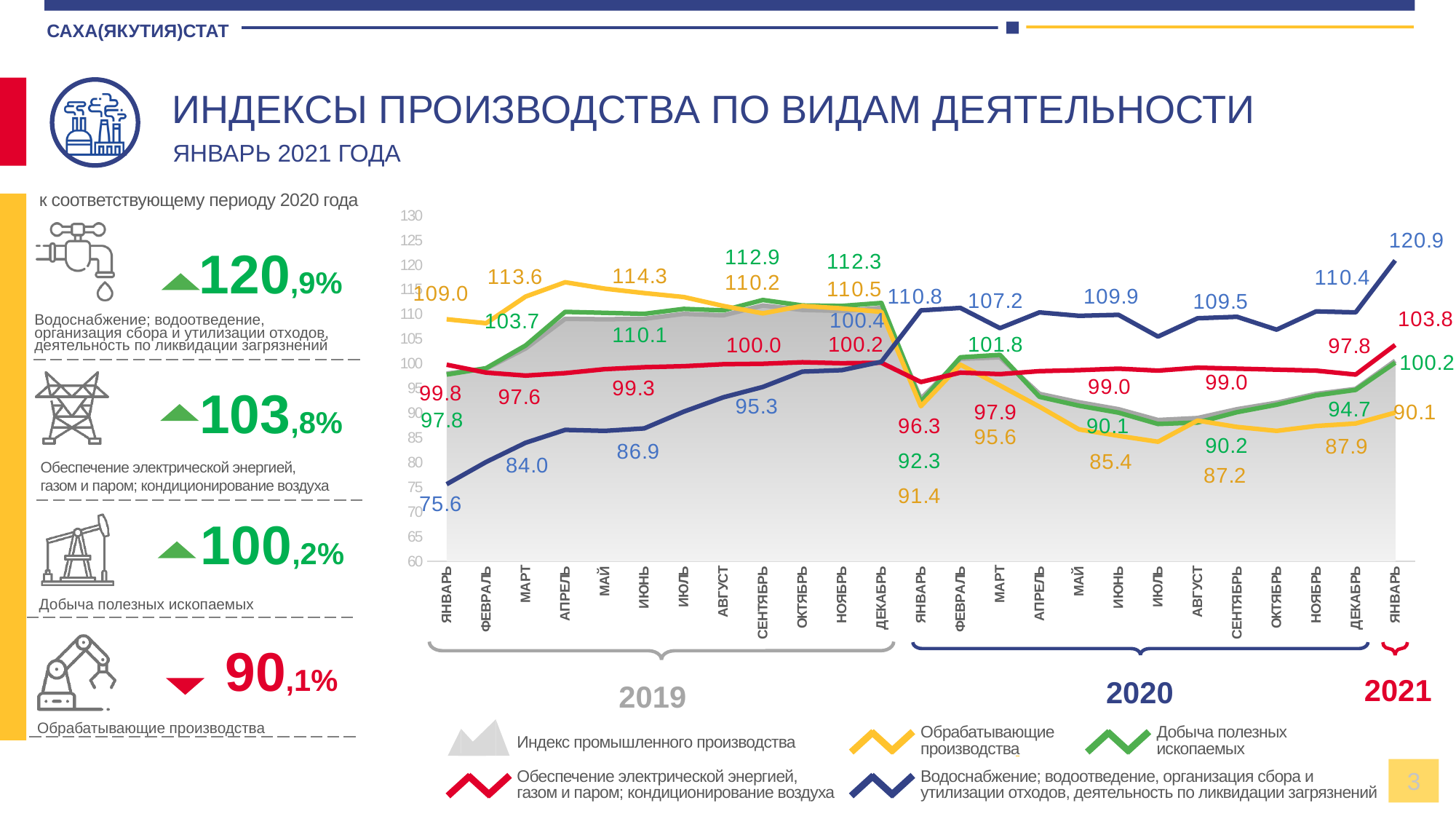
How many months are plotted along the x axis of the chart? 25 What is the value of the Добыча полезных ископаемых series for ЯНВАРЬ 2020? 92.3 Is the value of the Обрабатывающие производства series for ИЮНЬ 2020 greater or less than 90? less What is the value of the Водоснабжение; водоотведение series for ЯНВАРЬ 2021? 120.9 How many series does the chart legend list? 5 What is the value of the Обеспечение электрической энергией, газом и паром series for ЯНВАРЬ 2020? 96.3 What is the difference between the Водоснабжение; водоотведение values for ЯНВАРЬ 2021 and ЯНВАРЬ 2019? 45.3 Does the Водоснабжение; водоотведение series generally rise or fall from ЯНВАРЬ 2019 to ЯНВАРЬ 2021? rise Which is larger in ЯНВАРЬ 2019: the Обрабатывающие производства value or the Водоснабжение; водоотведение value? Обрабатывающие производства What is the value of the Обрабатывающие производства series for ЯНВАРЬ 2021? 90.1 What kind of chart is shown on the slide? line chart In which month does the Водоснабжение; водоотведение series reach its lowest value? ЯНВАРЬ 2019